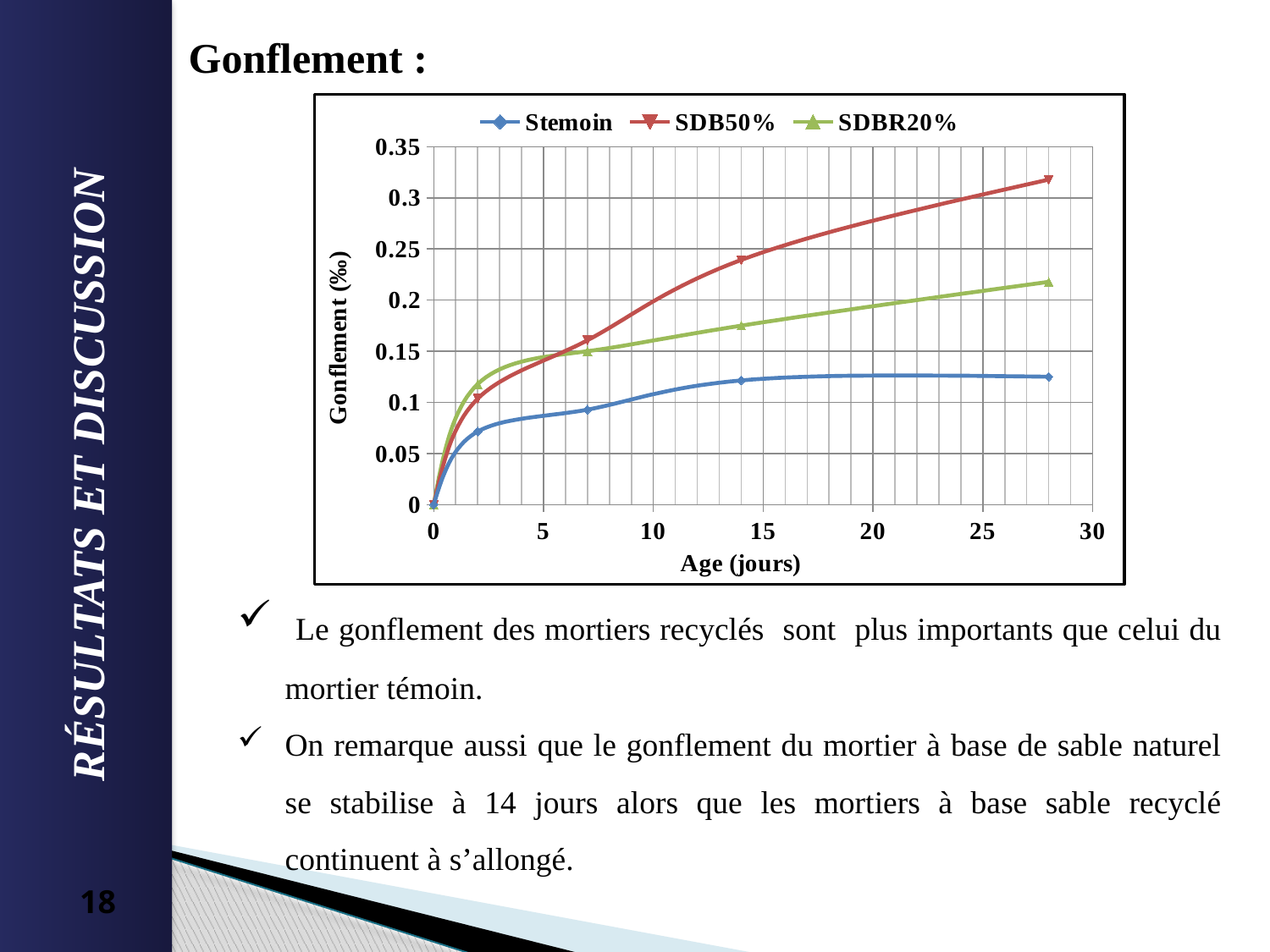
Is the value for SDB50% at 28 days greater or less than 0.3? greater What kind of chart is shown on the slide? line chart Is the value for SDB50% at 14 days greater or less than 0.2? greater Which series has the highest value at 28 days? SDB50% How many series does the legend list? 3 At 14 days, which is larger: the value for SDB50% or the value for SDBR20%? SDB50% Is the value for Stemoin at 28 days greater or less than 0.15? less How many data points are plotted for each series? 5 Which series has the lowest value at 28 days? Stemoin What is the title of the x axis? Age (jours) Does the SDB50% series rise or fall as age increases? rise